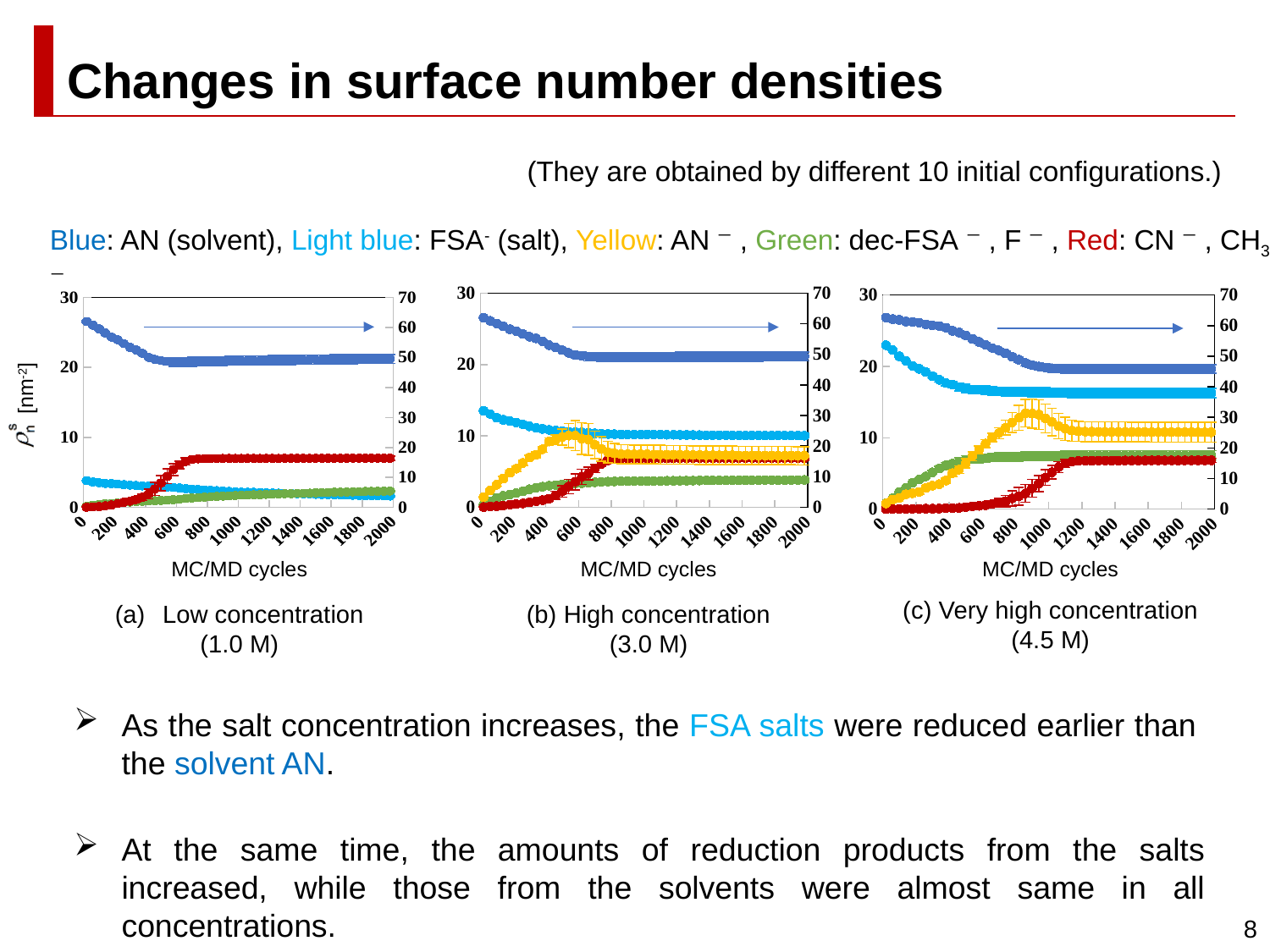
In chart (b) High concentration (3.0 M), which is larger at 2000 cycles: the light blue FSA- series or the green series? light blue FSA- How many charts are shown on the slide? 3 In chart (c) Very high concentration (4.5 M), does the red series rise or fall along the x axis? rise In chart (a) Low concentration (1.0 M), is the red series value at 2000 cycles greater or less than 10 on the left axis? less In chart (c) Very high concentration (4.5 M), which is larger at 2000 cycles: the light blue FSA- series or the red series? light blue FSA- In chart (a) Low concentration (1.0 M), does the light blue FSA- series rise or fall along the x axis? fall In chart (c) Very high concentration (4.5 M), is the light blue FSA- value at 2000 cycles greater or less than 10 on the left axis? greater In chart (c) Very high concentration (4.5 M), is the light blue FSA- value at 0 cycles greater or less than 20 on the left axis? greater What kind of chart is used in panel (a) Low concentration (1.0 M)? line chart In chart (a) Low concentration (1.0 M), does the dark blue AN (solvent) series rise or fall along the x axis? fall What is the x-axis label of the chart (b) High concentration (3.0 M)? MC/MD cycles What is the maximum value shown on the x axis of chart (c) Very high concentration (4.5 M)? 2000